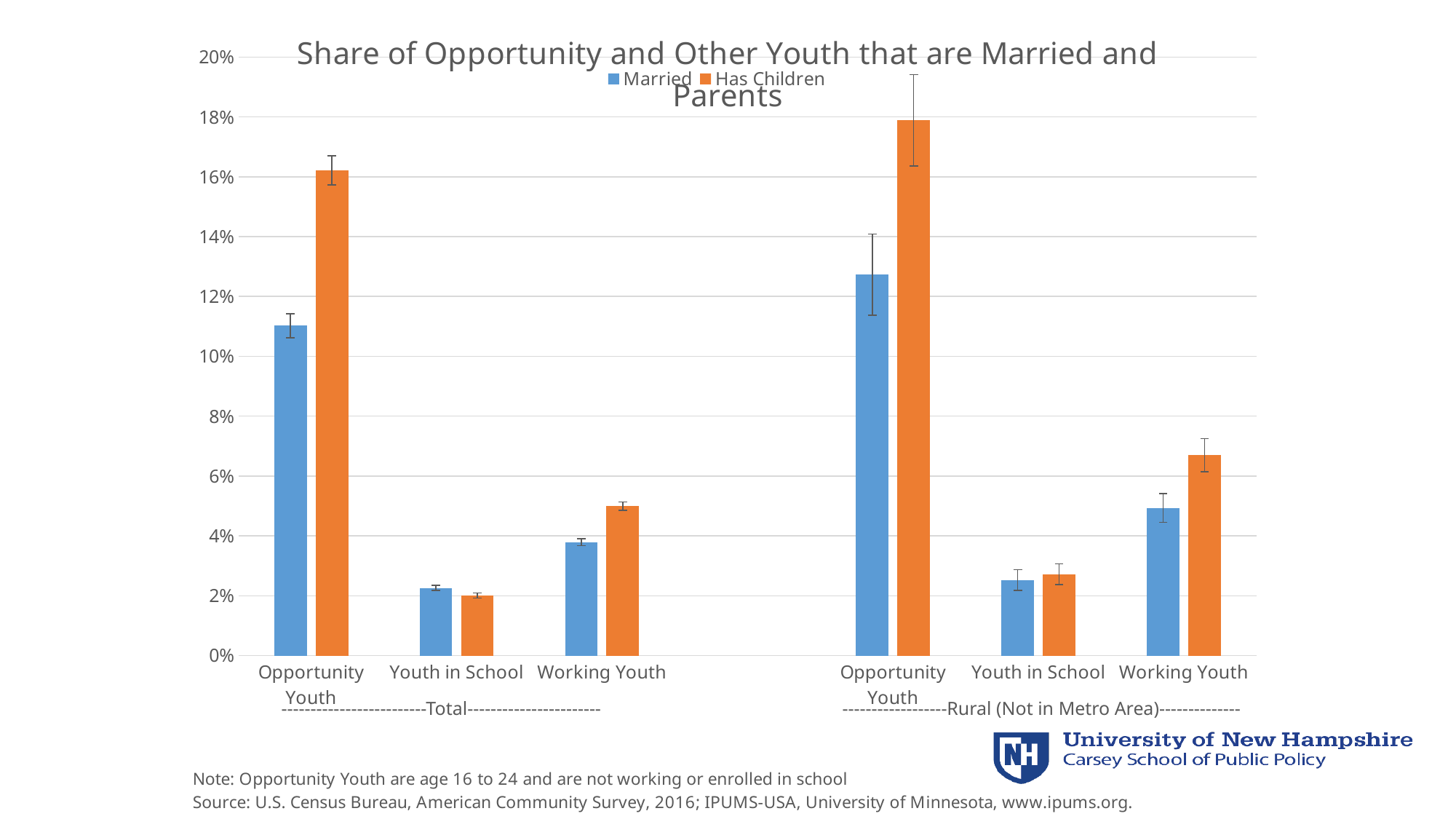
Is the Married value for Opportunity Youth in the Total group greater or less than 10%? greater Which is larger: the Married share for Opportunity Youth in the Total group or in the Rural (Not in Metro Area) group? Rural (Not in Metro Area) Is the Has Children value for Opportunity Youth in the Total group greater or less than 14%? greater How many youth categories are shown within the Total group? 3 Which group has the highest Has Children share on the chart? Opportunity Youth in the Rural (Not in Metro Area) group What is the title of the chart? Share of Opportunity and Other Youth that are Married and Parents For Working Youth in the Total group, which is larger: the Married share or the Has Children share? Has Children How many series does the legend list? 2 Is the Has Children value for Opportunity Youth in the Rural (Not in Metro Area) group greater or less than 16%? greater What are the two series named in the legend? Married and Has Children What kind of chart is shown on the slide? Bar chart